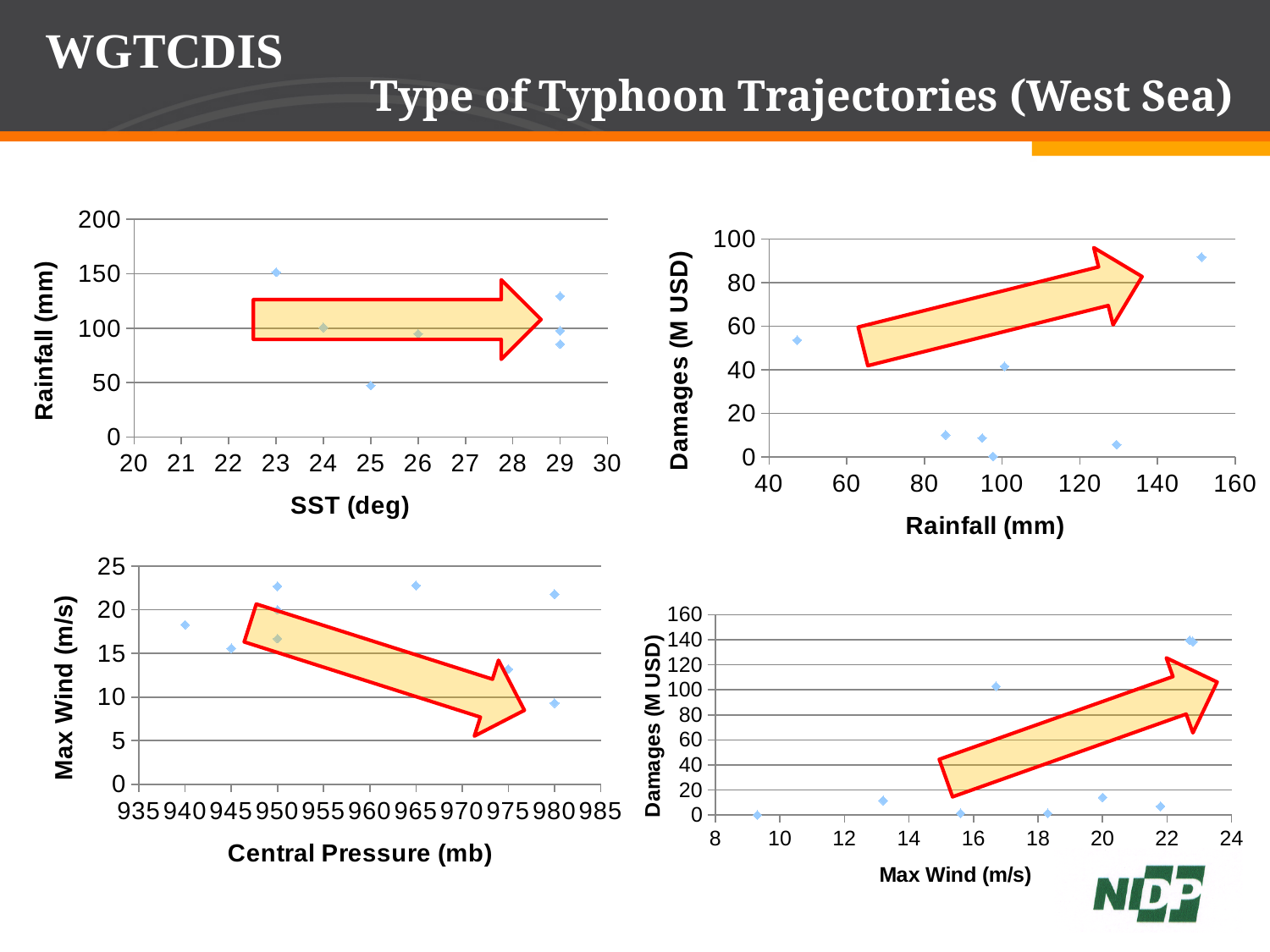
How many charts are shown on the slide? 4 In the bottom-right chart (Damages vs Max Wind), is the highest damages value greater or less than 120? greater In the bottom-left chart (Max Wind vs Central Pressure), does the arrow indicate max wind rising or falling as central pressure increases? Falling In the top-left chart (Rainfall vs SST), at which SST value is the highest rainfall point plotted? 23 What kind of chart is the top-left chart with SST (deg) on the x axis? Scatter chart In the top-left chart (Rainfall vs SST), how many data points are plotted? 7 In the bottom-right chart (Damages vs Max Wind), does the arrow indicate damages rising or falling as max wind increases? Rising In the bottom-left chart (Max Wind vs Central Pressure), is the max wind value for the point at 940 mb greater or less than 15? greater What is the y-axis label of the bottom-right chart? Damages (M USD) In the top-right chart (Damages vs Rainfall), is the highest damages value greater or less than 80? greater In the top-right chart (Damages vs Rainfall), does the arrow indicate damages rising or falling as rainfall increases? Rising